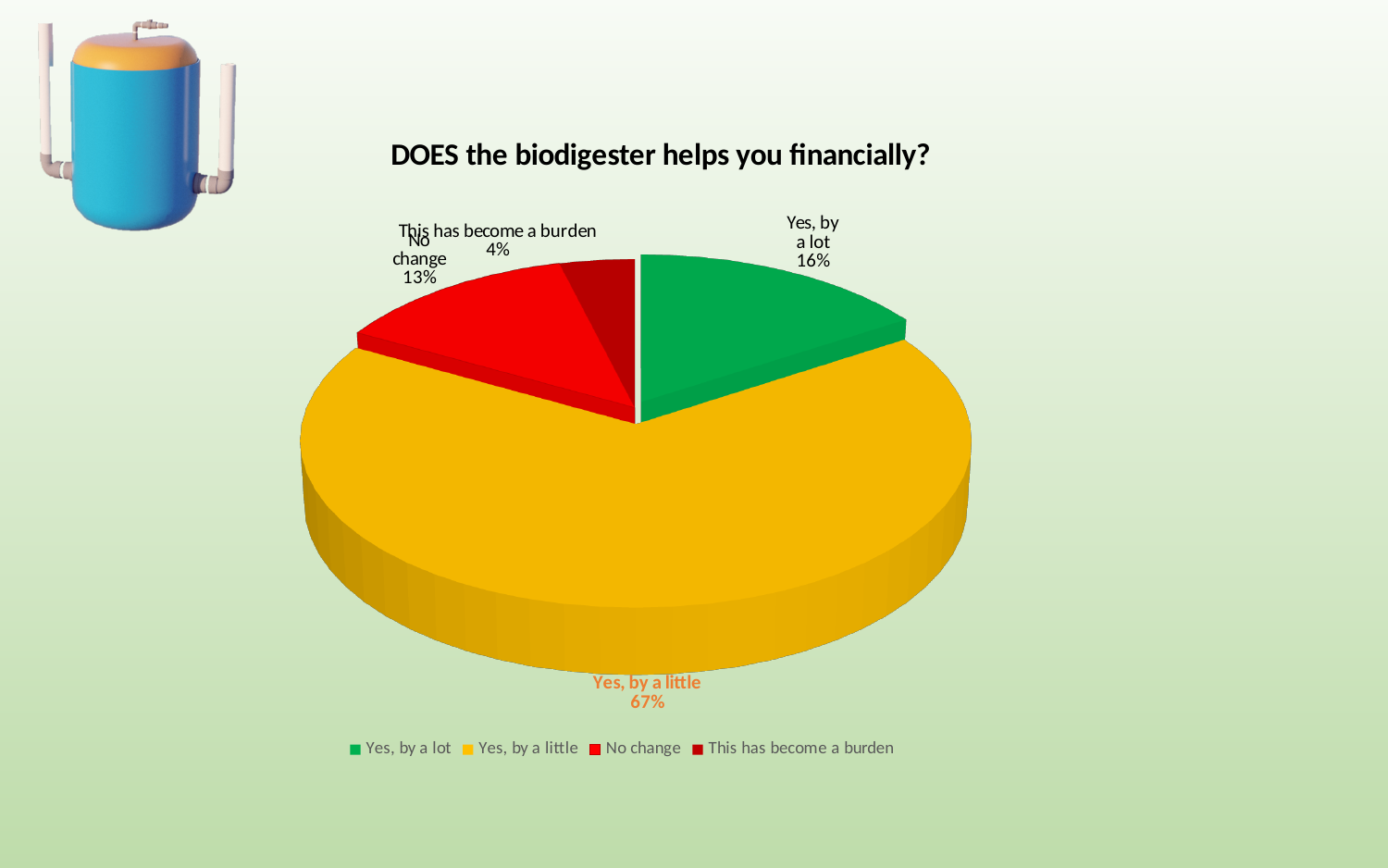
What share of the pie is 'Yes, by a lot'? 16% What is the title of the chart? DOES the biodigester helps you financially? Which is larger, the share for 'No change' or the share for 'Yes, by a lot'? Yes, by a lot What share of the pie is 'This has become a burden'? 4% How many categories does the pie chart have? 4 Which category has the largest share of the pie? Yes, by a little What is the difference in percentage points between 'Yes, by a little' and 'Yes, by a lot'? 51 What kind of chart is shown on the slide? Pie chart What share of the pie is 'No change'? 13% Which category has the smallest share of the pie? This has become a burden What colour is the 'Yes, by a lot' slice? Green